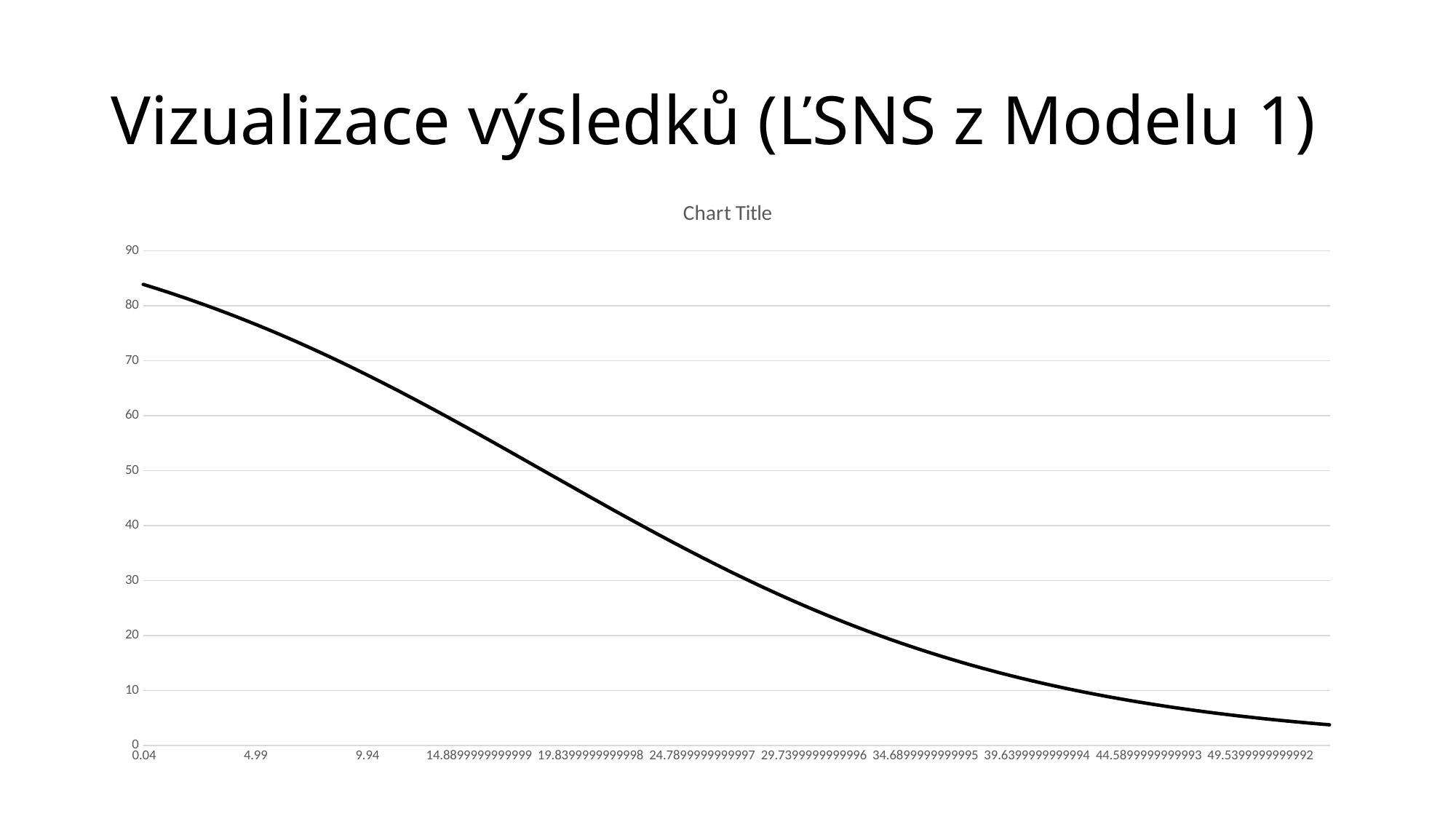
Is the value at x = 44.5899999999993 greater or less than 10? less Is the value at x = 19.8399999999998 greater or less than 50? less Is the value at x = 0.04 greater or less than 80? greater What kind of chart is shown on the slide? line chart What is the title shown above the chart? Chart Title At which labelled x-axis value is the line highest? 0.04 Do the plotted values rise or fall as you move from left to right along the x axis? fall At which labelled x-axis value is the line lowest? 49.5399999999992